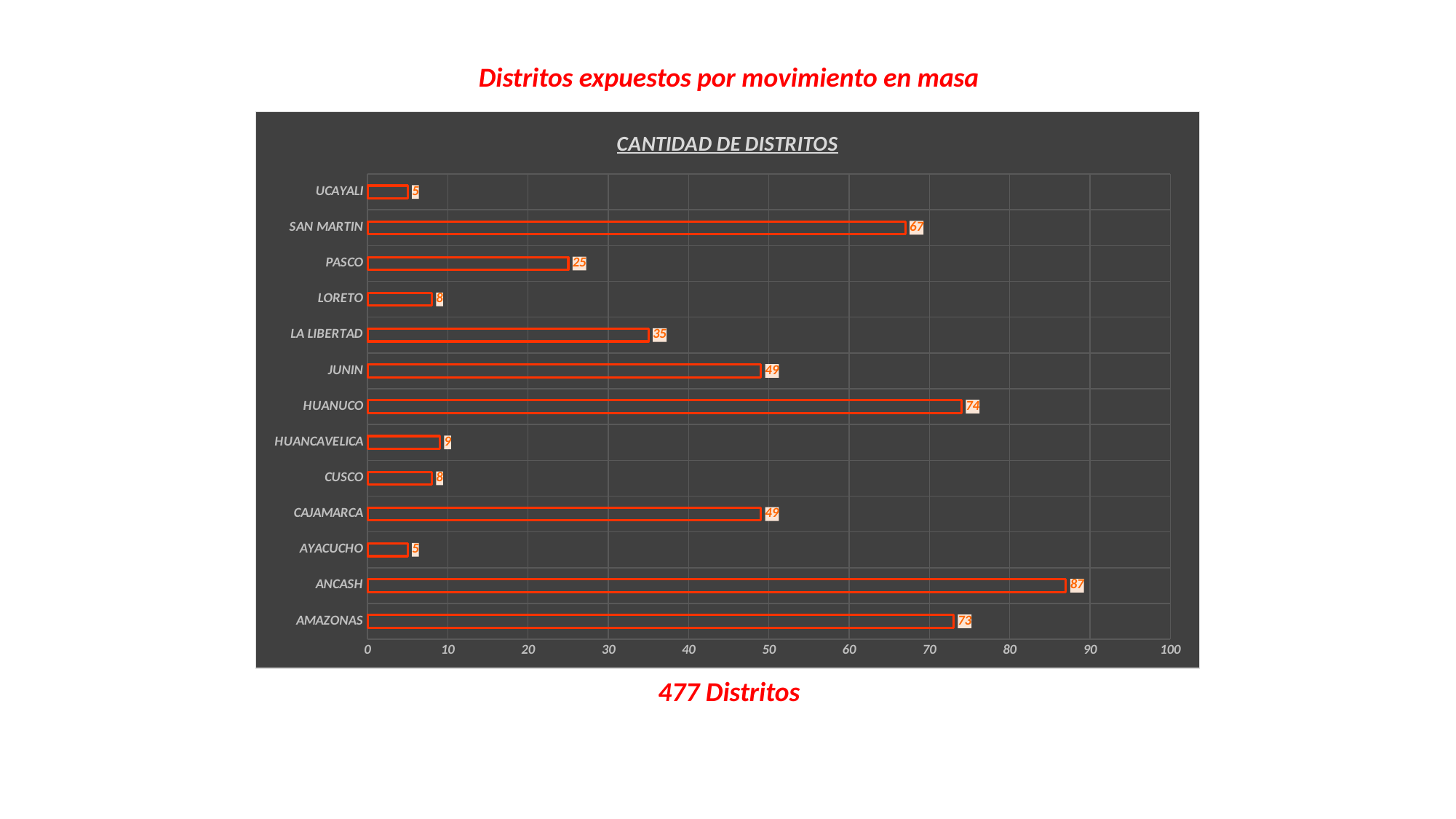
Which is larger, the value for JUNIN or the value for LA LIBERTAD? JUNIN Is the value for HUANUCO greater or less than 70? greater What is the value for SAN MARTIN? 67 Which category has the highest value? ANCASH What is the difference between the values for SAN MARTIN and PASCO? 42 What is the title of the chart? CANTIDAD DE DISTRITOS What is the difference between the values for HUANUCO and AMAZONAS? 1 What kind of chart is shown on the slide? bar chart How many categories are shown on the chart? 13 What is the value for LA LIBERTAD? 35 What total number of districts is stated below the chart? 477 Distritos What is the value for ANCASH? 87